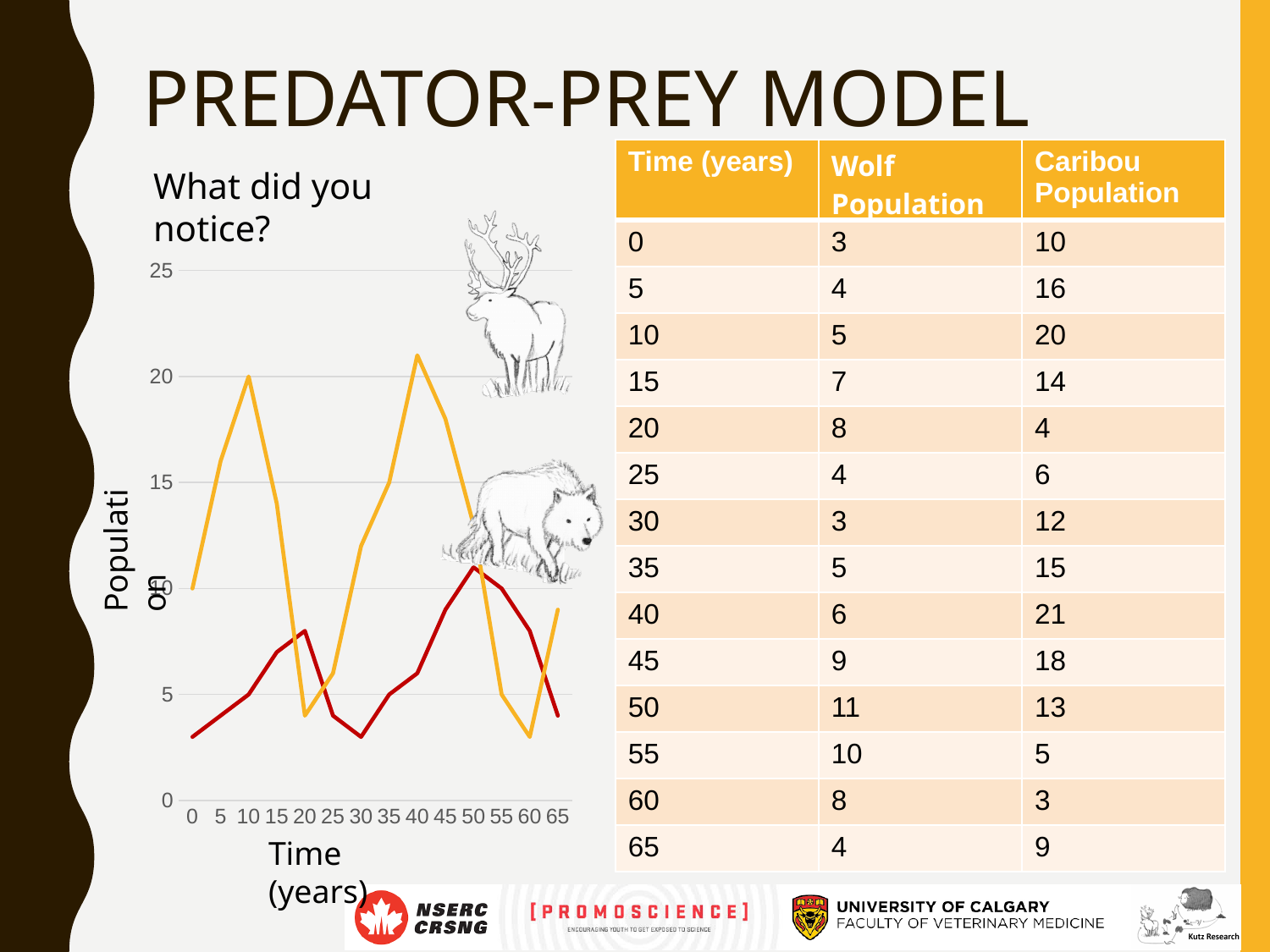
At 20 years, which population is larger, wolf or caribou? wolf How many lines are plotted on the chart? 2 How many time points are plotted along the x axis of the chart? 14 What is the title of the chart's x axis? Time (years) At which time (years) is the wolf population highest? 50 Is the value of the orange line at 40 years greater or less than 20? greater According to the slide, what is the wolf population at 50 years? 11 At 10 years, how much larger is the caribou population than the wolf population? 15 What kind of chart is shown on the slide? line chart According to the slide, what is the caribou population at 40 years? 21 Is the value of the red line at 30 years greater or less than 5? less At which time (years) is the caribou population lowest? 60